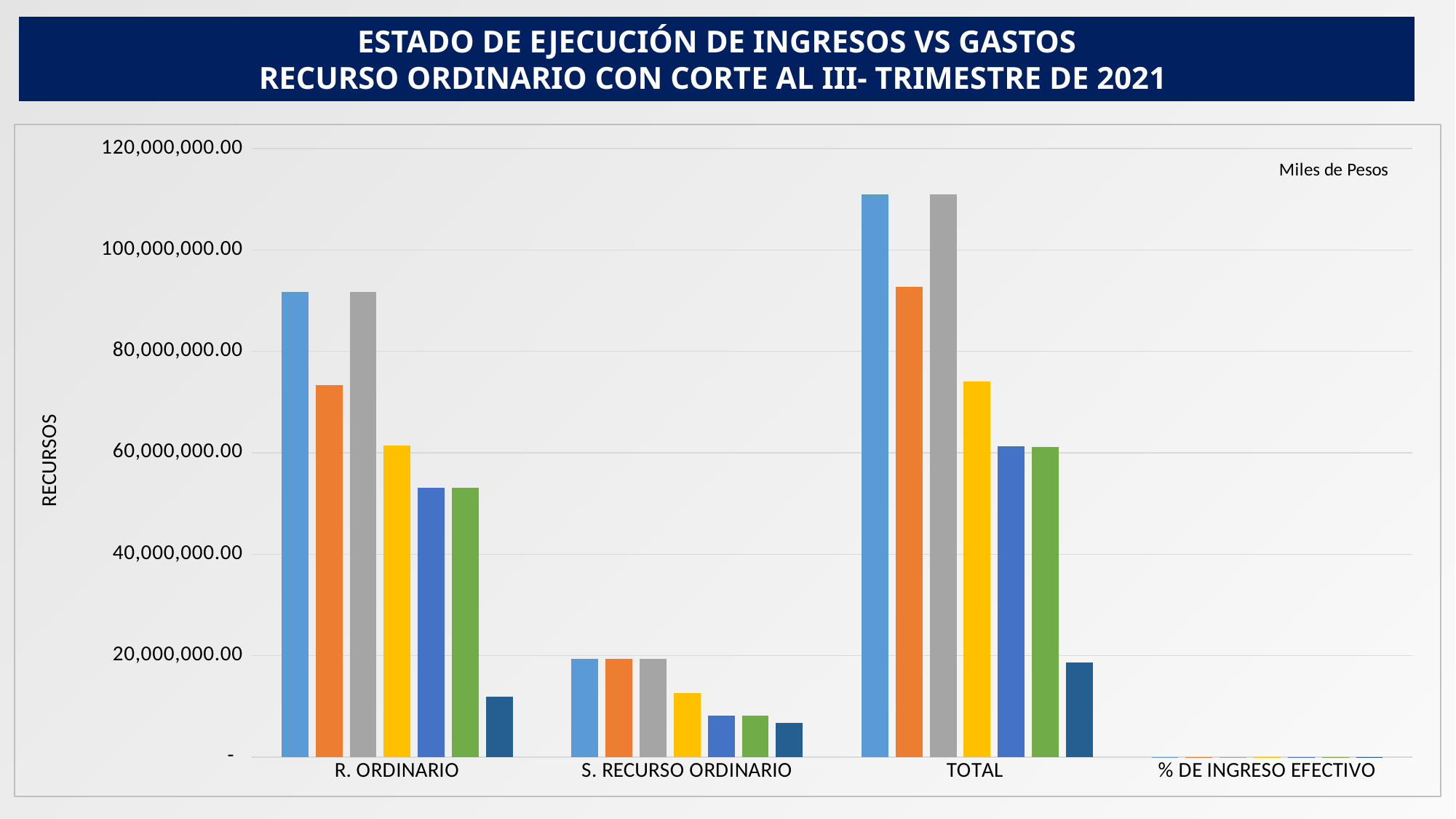
Which category has the smallest bars in the chart? % DE INGRESO EFECTIVO Is the value of the dark blue bar for R. ORDINARIO greater or less than 20,000,000.00? less How many bars are plotted for the R. ORDINARIO category? 7 Is the value of the yellow bar for S. RECURSO ORDINARIO greater or less than 20,000,000.00? less What is the label on the vertical axis of the chart? RECURSOS Is the value of the light blue bar for TOTAL greater or less than 100,000,000.00? greater Which is larger: the orange bar for R. ORDINARIO or the orange bar for S. RECURSO ORDINARIO? R. ORDINARIO Which category has the tallest bars in the chart? TOTAL What kind of chart is shown on the slide? bar chart How many categories are shown on the x axis of the chart? 4